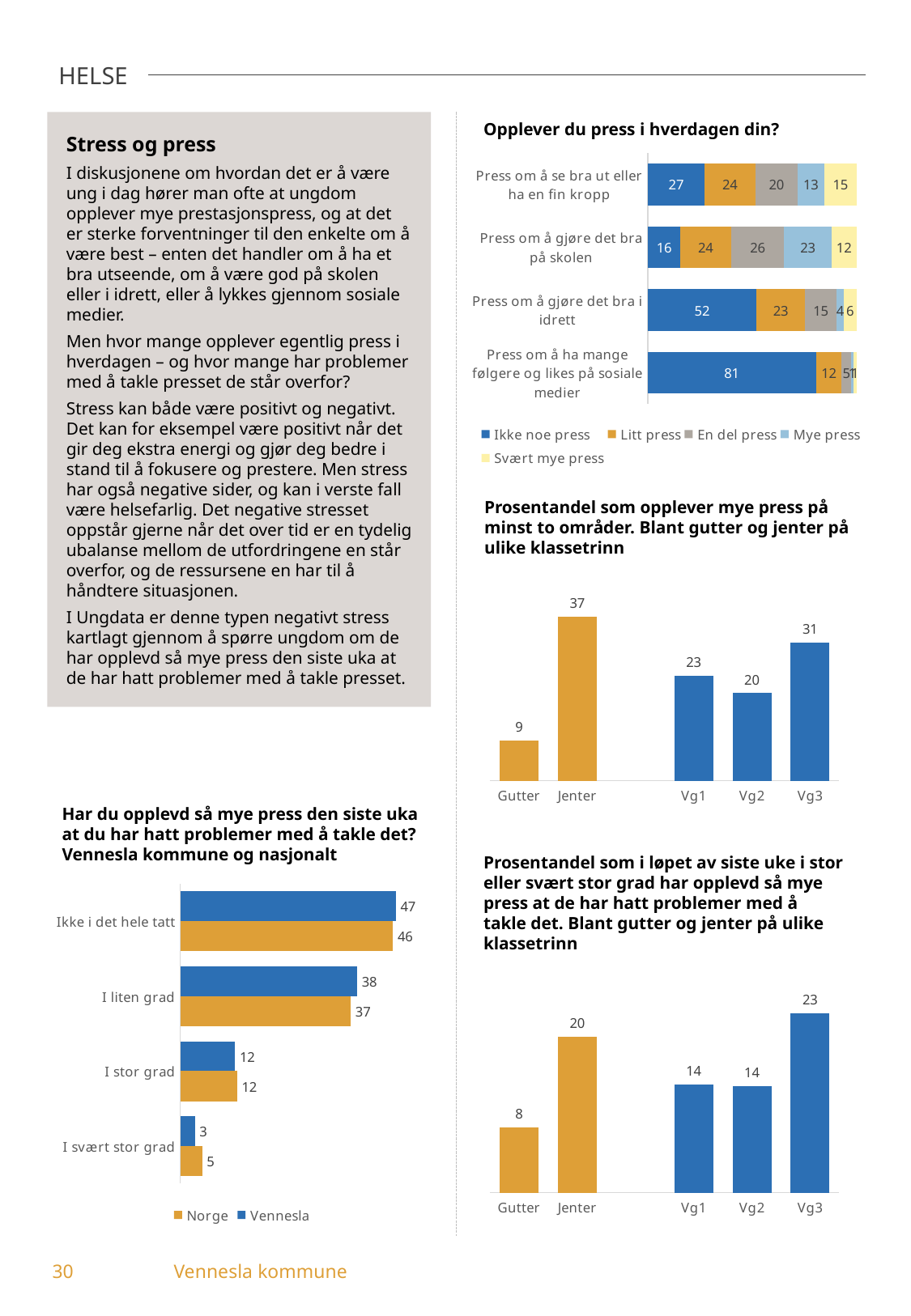
In the chart 'Opplever du press i hverdagen din?', what is the total of the stacked bar for 'Press om å gjøre det bra på skolen'? 101 In the chart 'Har du opplevd så mye press den siste uka at du har hatt problemer med å takle det?', how many categories are shown? 4 In the chart 'Prosentandel som opplever mye press på minst to områder', what is the value for Vg2? 20 In the chart 'Har du opplevd så mye press den siste uka at du har hatt problemer med å takle det?', what is the value for Norge for 'I svært stor grad'? 5 In the chart 'Opplever du press i hverdagen din?', what is the value for 'Svært mye press' for 'Press om å se bra ut eller ha en fin kropp'? 15 In the chart 'Prosentandel som i løpet av siste uke i stor eller svært stor grad har opplevd så mye press', which category has the lowest value? Gutter In the chart 'Har du opplevd så mye press den siste uka at du har hatt problemer med å takle det?', which is larger for 'I liten grad': Norge or Vennesla? Vennesla In the chart 'Prosentandel som opplever mye press på minst to områder', which category has the highest value? Jenter In the chart 'Prosentandel som opplever mye press på minst to områder', what is the difference between Jenter and Gutter? 28 In the chart 'Opplever du press i hverdagen din?', how many series does the legend list? 5 In the chart 'Prosentandel som i løpet av siste uke i stor eller svært stor grad har opplevd så mye press', what is the value for Vg3? 23 In the chart 'Opplever du press i hverdagen din?', what is the value for 'Ikke noe press' for 'Press om å ha mange følgere og likes på sosiale medier'? 81